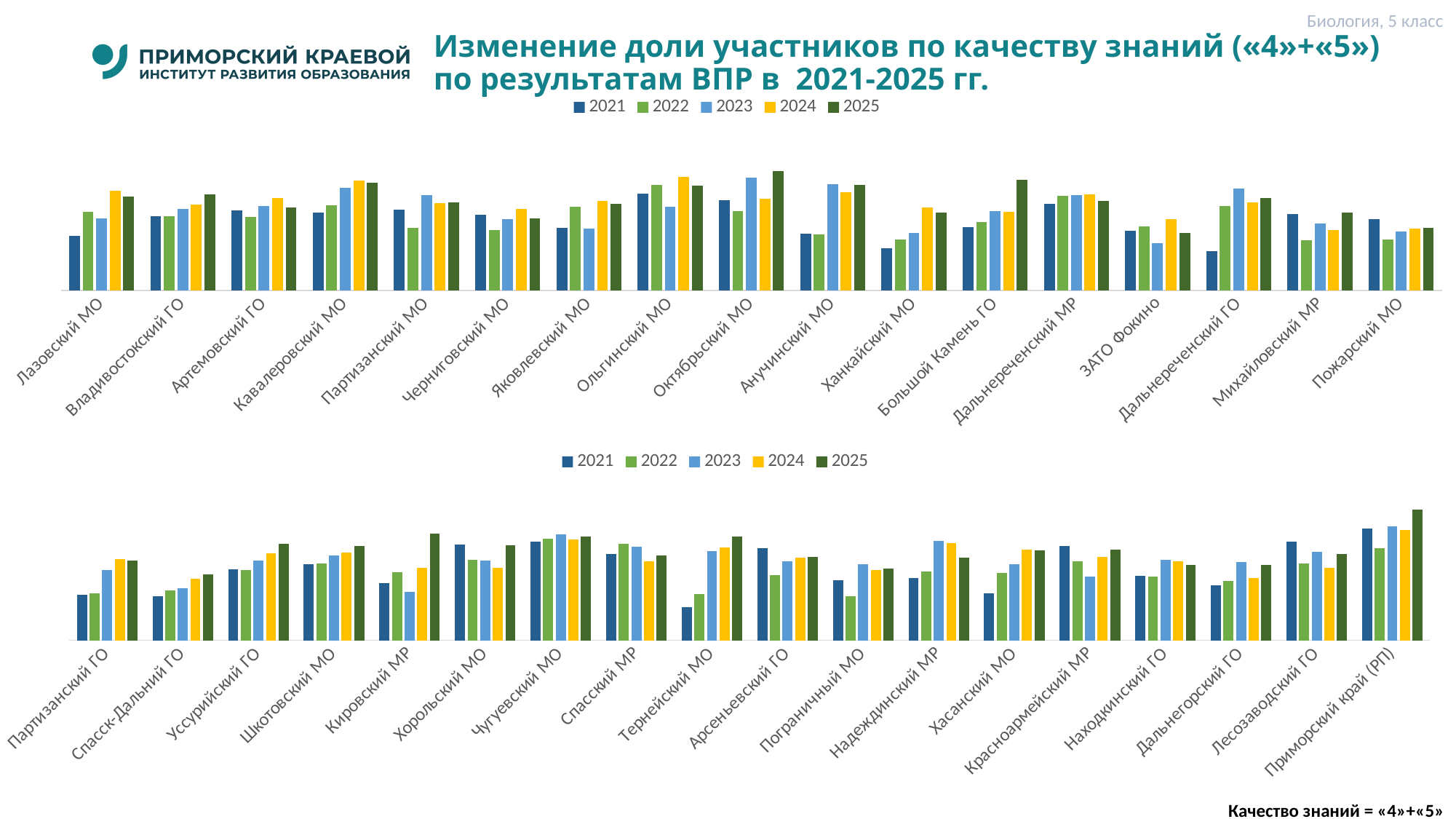
How many categories are shown on the x axis of the bottom chart? 18 In the top chart, for Дальнереченский ГО, which is larger: the value for 2021 or the value for 2023? 2023 In the bottom chart, for Партизанский ГО, which is larger: the value for 2021 or the value for 2025? 2025 In the top chart, for Лазовский МО, which is larger: the value for 2021 or the value for 2024? 2024 How many categories are shown on the x axis of the top chart? 17 In the bottom chart, which year has the highest value for Приморский край (РП)? 2025 In the bottom chart, which year has the lowest value for Тернейский МО? 2021 In the bottom chart, do the values for Уссурийский ГО generally rise or fall from 2021 to 2025? rise What kind of chart is the top chart on the slide? bar chart In the top chart, which year has the highest value for Большой Камень ГО? 2025 How many series does the legend of the top chart list? 5 Which years are listed in the legend of the bottom chart? 2021, 2022, 2023, 2024, 2025